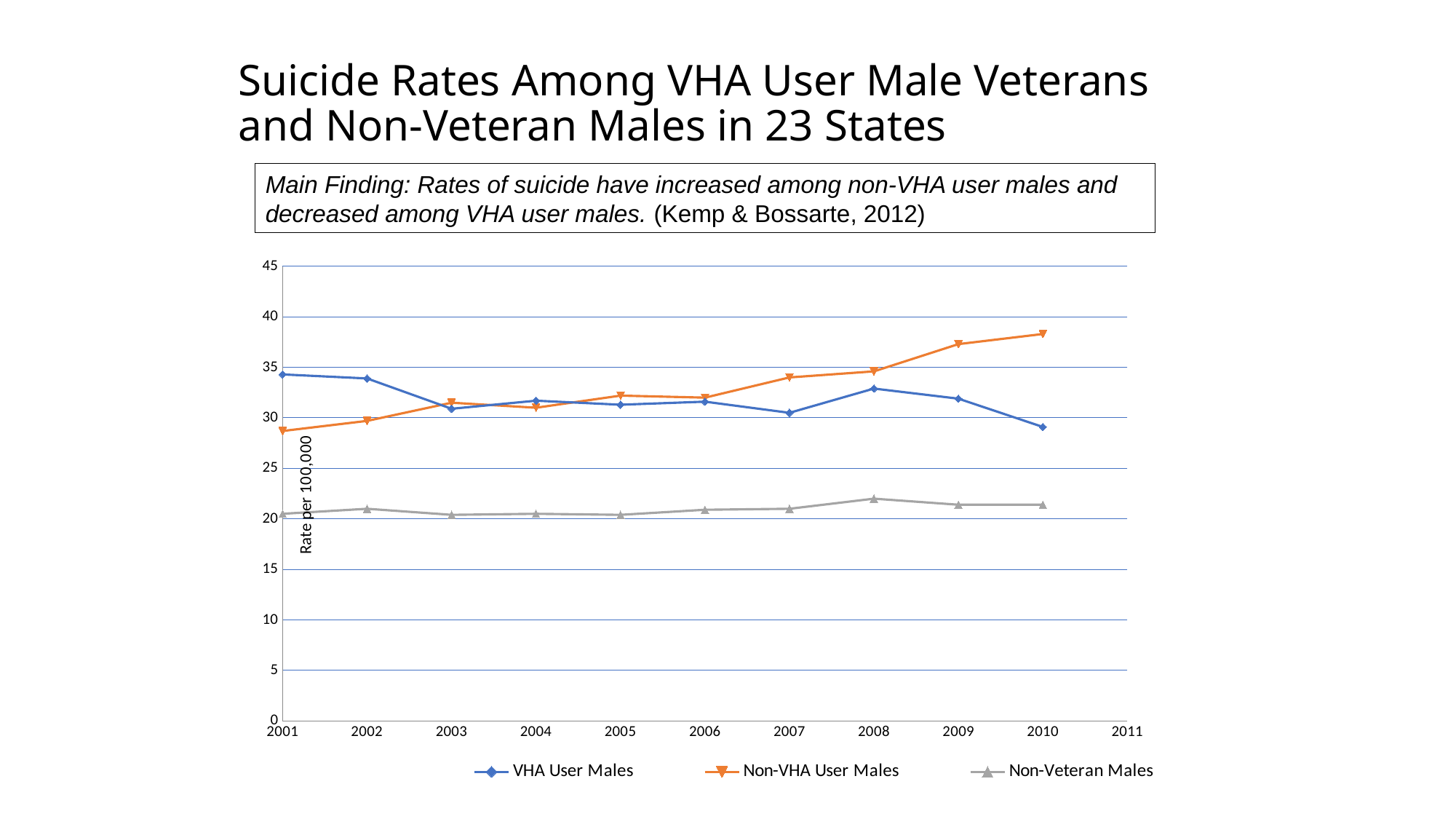
In 2001, which is larger: VHA User Males or Non-VHA User Males? VHA User Males Is the value for Non-VHA User Males in 2001 greater or less than 30? less In 2010, which is larger: VHA User Males or Non-VHA User Males? Non-VHA User Males Which series has the lowest values across all years? Non-Veteran Males In which year is the Non-VHA User Males series at its highest? 2010 Does the Non-VHA User Males series generally rise or fall from 2001 to 2010? rise Is the value for Non-VHA User Males in 2010 greater or less than 35? greater Is the value for VHA User Males in 2010 greater or less than 30? less How many years have data points plotted for the VHA User Males series? 10 How many series does the legend list? 3 What kind of chart is shown on the slide? line chart